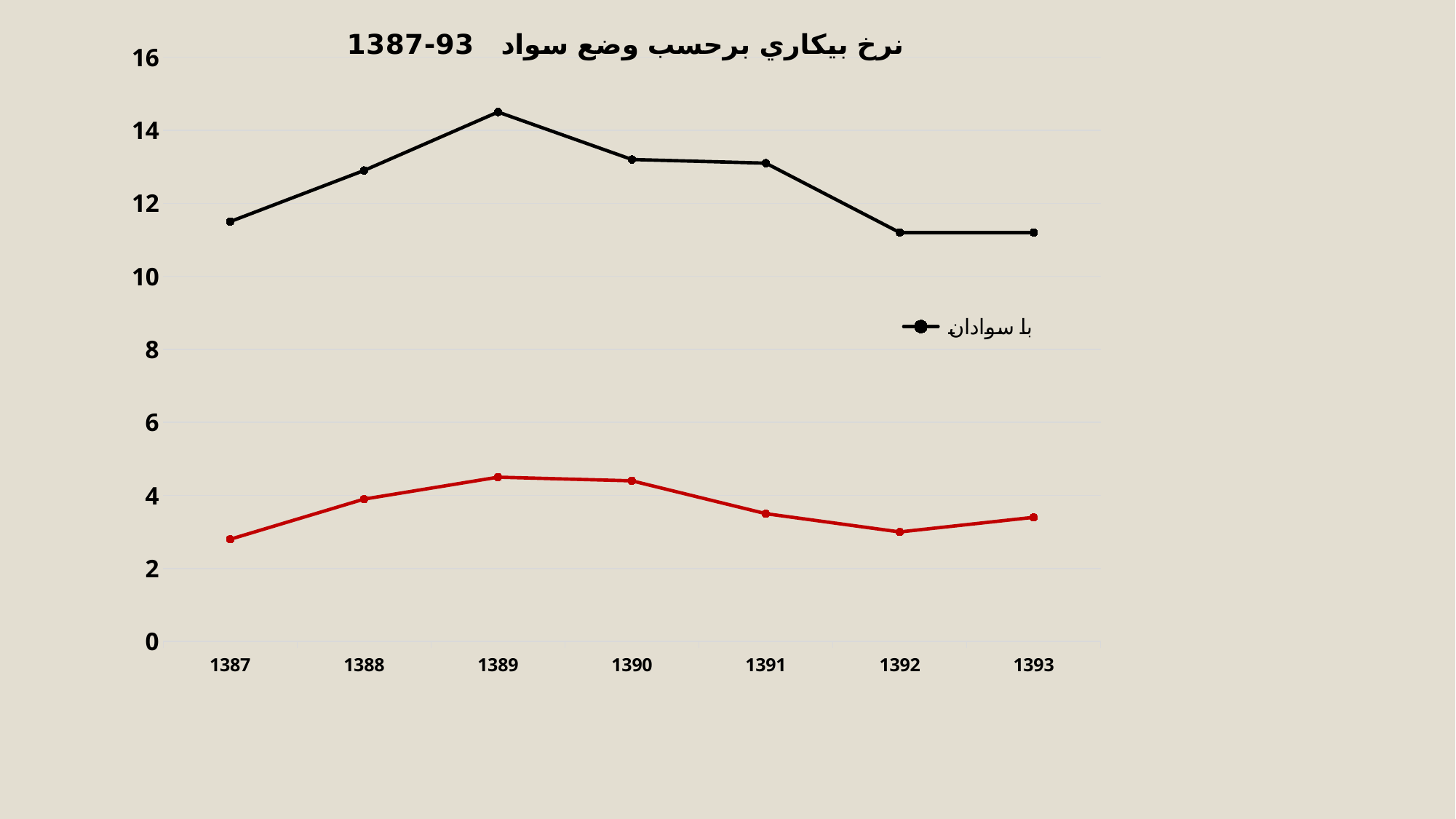
How many series does the legend list? 1 What kind of chart is shown on the slide? line chart How many years are plotted along the x axis? 7 What is the title of the chart? نرخ بیکاری برحسب وضع سواد 1387-93 For the black line (با سوادان), which year has the larger value, 1387 or 1389? 1389 Is the value of the black line (با سوادان) in 1387 greater or less than 12? less In which year does the black line (با سوادان) reach its highest value? 1389 Is the value of the red line in 1389 greater or less than 4? greater Is the value of the black line (با سوادان) in 1389 greater or less than 14? greater What is the legend entry shown for the black line? با سوادان Does the black line (با سوادان) rise or fall from 1389 to 1392? fall